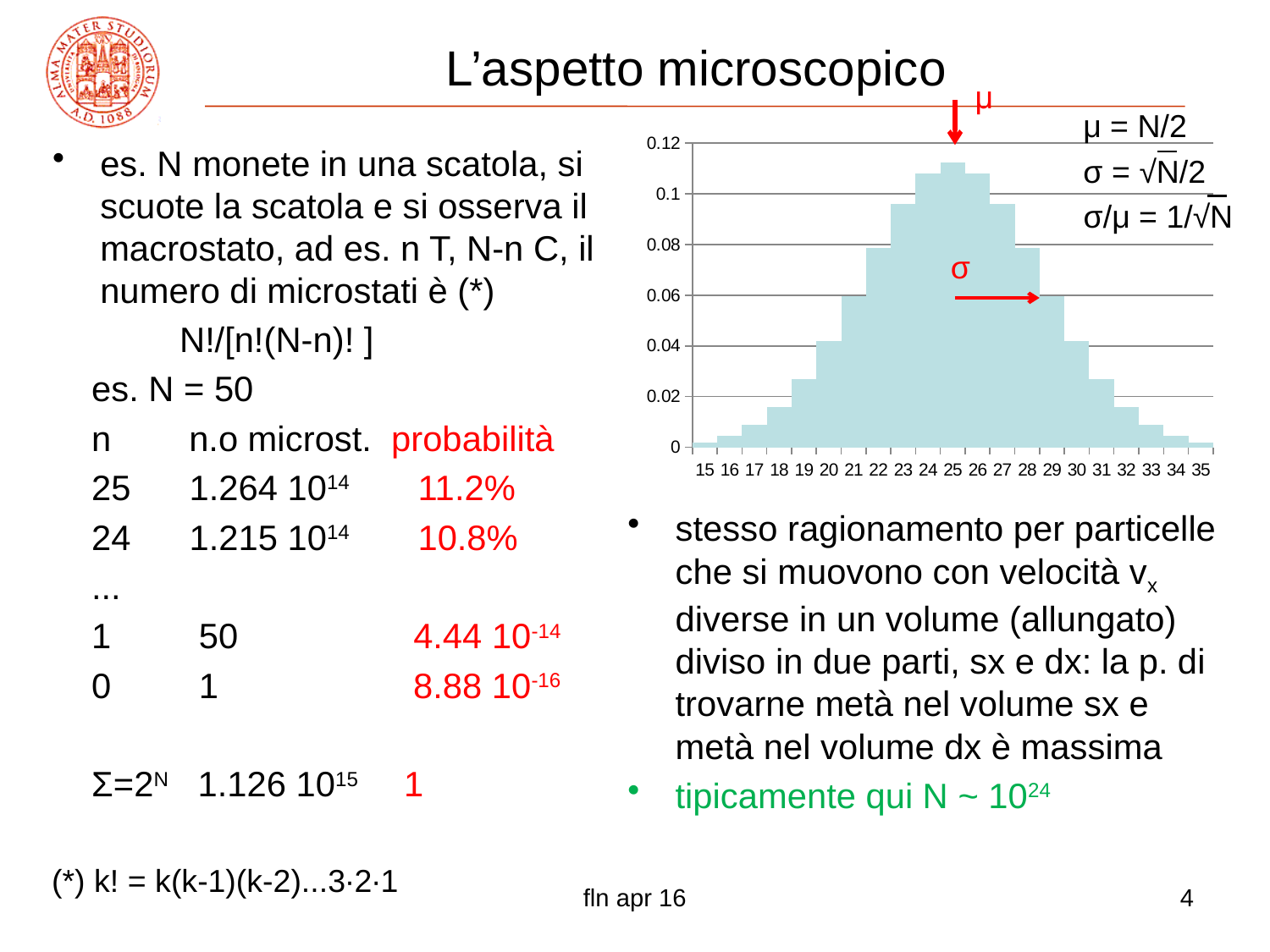
What is the highest tick value shown on the chart's y axis? 0.12 How many categories are shown along the x axis of the chart? 21 Is the value for 23 greater or less than 0.1? less Is the value for 31 greater or less than 0.04? less Is the value for 33 greater or less than 0.02? less What kind of chart is shown on the slide? bar chart Do the bar values rise or fall as the x axis goes from 15 to 25? rise Which is larger, the value for 25 or the value for 20? 25 Which category on the x axis has the highest bar? 25 Do the bar values rise or fall as the x axis goes from 25 to 35? fall